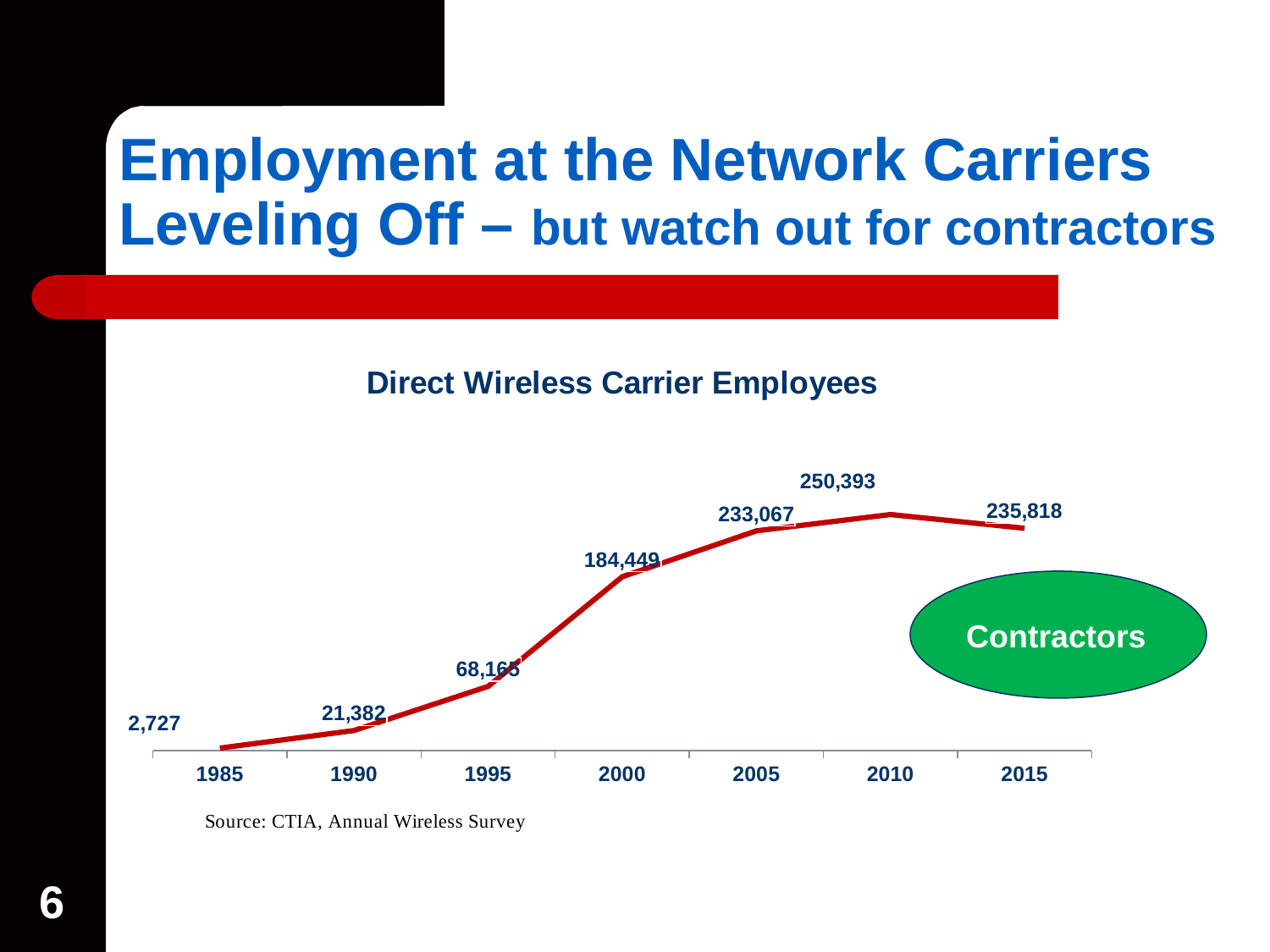
Which is larger in the Direct Wireless Carrier Employees chart, the value for 2005 or the value for 2015? 2015 What is the value for 2000 in the Direct Wireless Carrier Employees chart? 184,449 What kind of chart is the Direct Wireless Carrier Employees chart? Line chart What is the difference between the 2010 and 2015 values in the Direct Wireless Carrier Employees chart? 14,575 What is the value for 1985 in the Direct Wireless Carrier Employees chart? 2,727 Do the values in the Direct Wireless Carrier Employees chart rise or fall from 1985 to 2010? Rise Which year has the highest value in the Direct Wireless Carrier Employees chart? 2010 What is the value for 2010 in the Direct Wireless Carrier Employees chart? 250,393 How many data points are plotted in the Direct Wireless Carrier Employees chart? 7 Which year has the lowest value in the Direct Wireless Carrier Employees chart? 1985 What is the difference between the 2005 and 2000 values in the Direct Wireless Carrier Employees chart? 48,618 What is the value for 2015 in the Direct Wireless Carrier Employees chart? 235,818